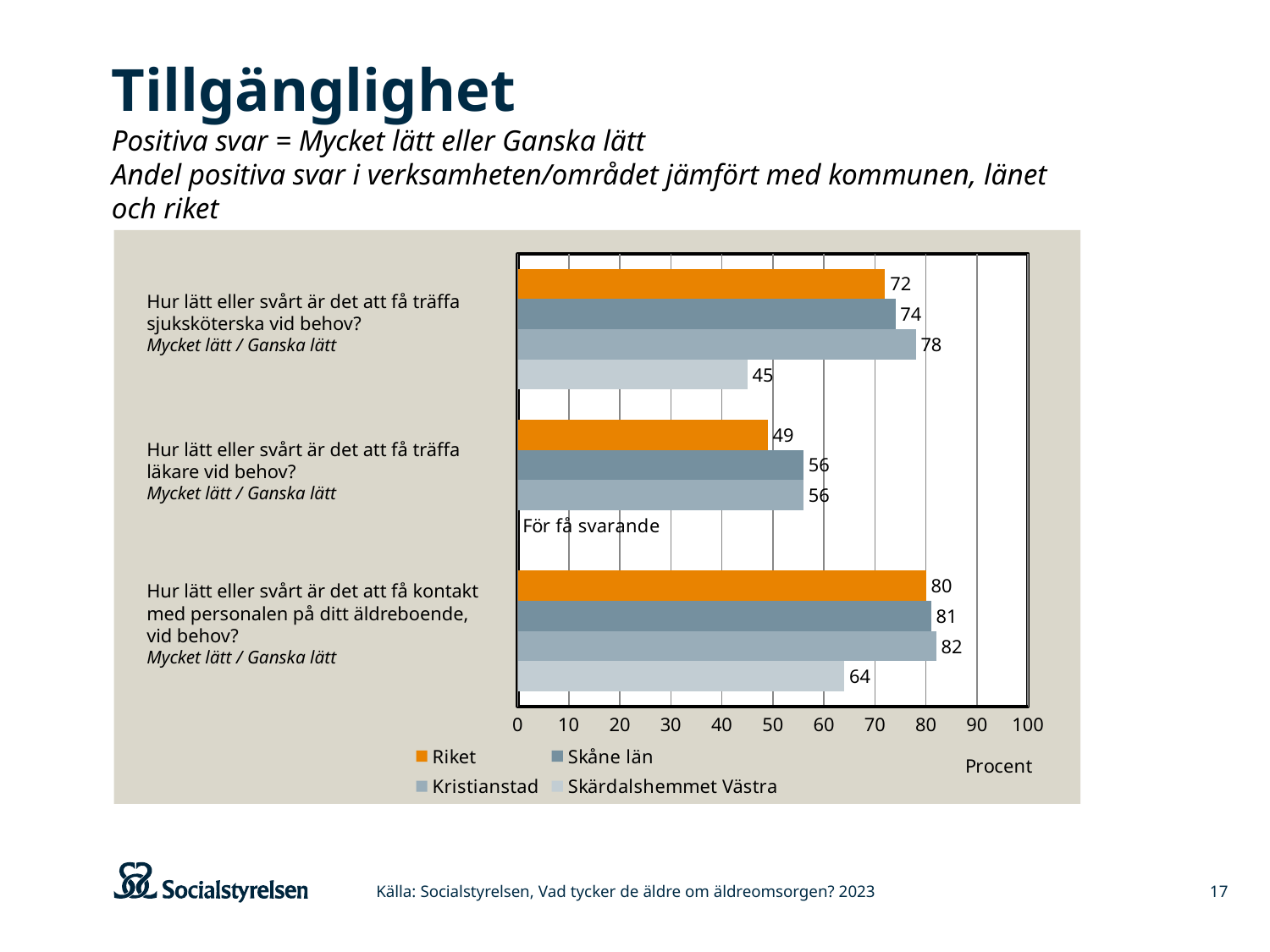
What kind of chart is shown on the slide? Bar chart What is the value for Riket on the question about meeting a doctor (läkare) when needed? 49 How many question categories are shown on the chart? 3 What is the difference between Kristianstad and Skärdalshemmet Västra on the question about meeting a nurse (sjuksköterska)? 33 How many series does the legend list? 4 Which series has the lowest value on the question about getting in contact with staff at the care home (kontakt med personalen)? Skärdalshemmet Västra What unit is shown on the horizontal axis of the chart? Procent Which is larger on the question about meeting a doctor (läkare): Riket or Skåne län? Skåne län What is shown for Skärdalshemmet Västra on the question about meeting a doctor (läkare) when needed? För få svarande What is the value for Skärdalshemmet Västra on the question about meeting a nurse (sjuksköterska) when needed? 45 Which series has the highest value on the question about meeting a nurse (sjuksköterska) when needed? Kristianstad What is the value for Kristianstad on the question about getting in contact with staff at the care home (kontakt med personalen)? 82